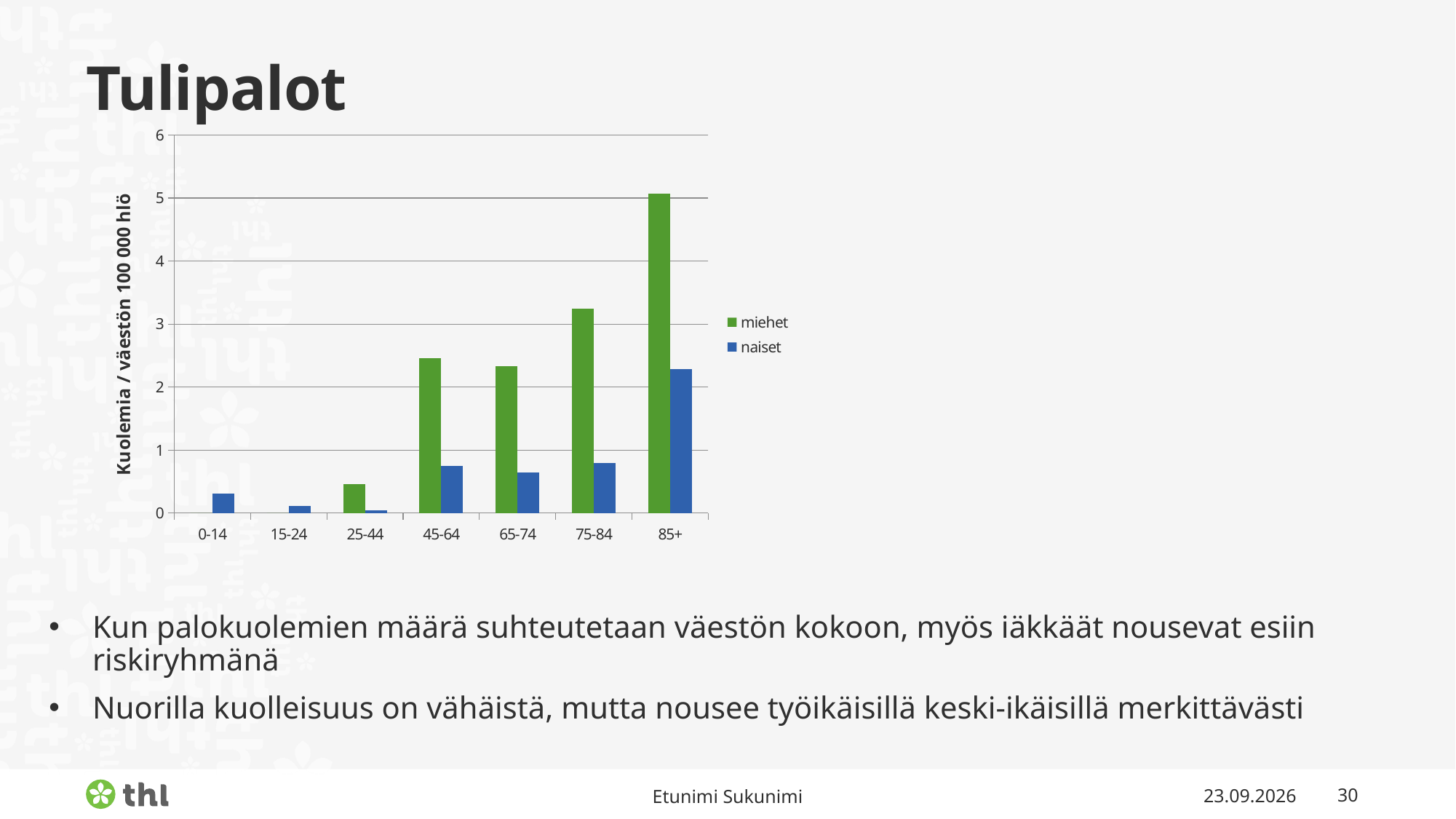
In the 85+ group, which series has the larger value, miehet or naiset? miehet Do the values for miehet rise or fall from the 65-74 group to the 85+ group? rise How many age-group categories are shown on the x axis? 7 Is the value for naiset in the 85+ group greater or less than 2? greater Is the value for miehet in the 75-84 group greater or less than 3? greater Which age group has the highest value for miehet? 85+ Is the value for miehet in the 85+ group greater or less than 4? greater What kind of chart is shown on the slide? bar chart How many series does the legend list? 2 What is the label of the y axis? Kuolemia / väestön 100 000 hlö Which age group has the highest value for naiset? 85+